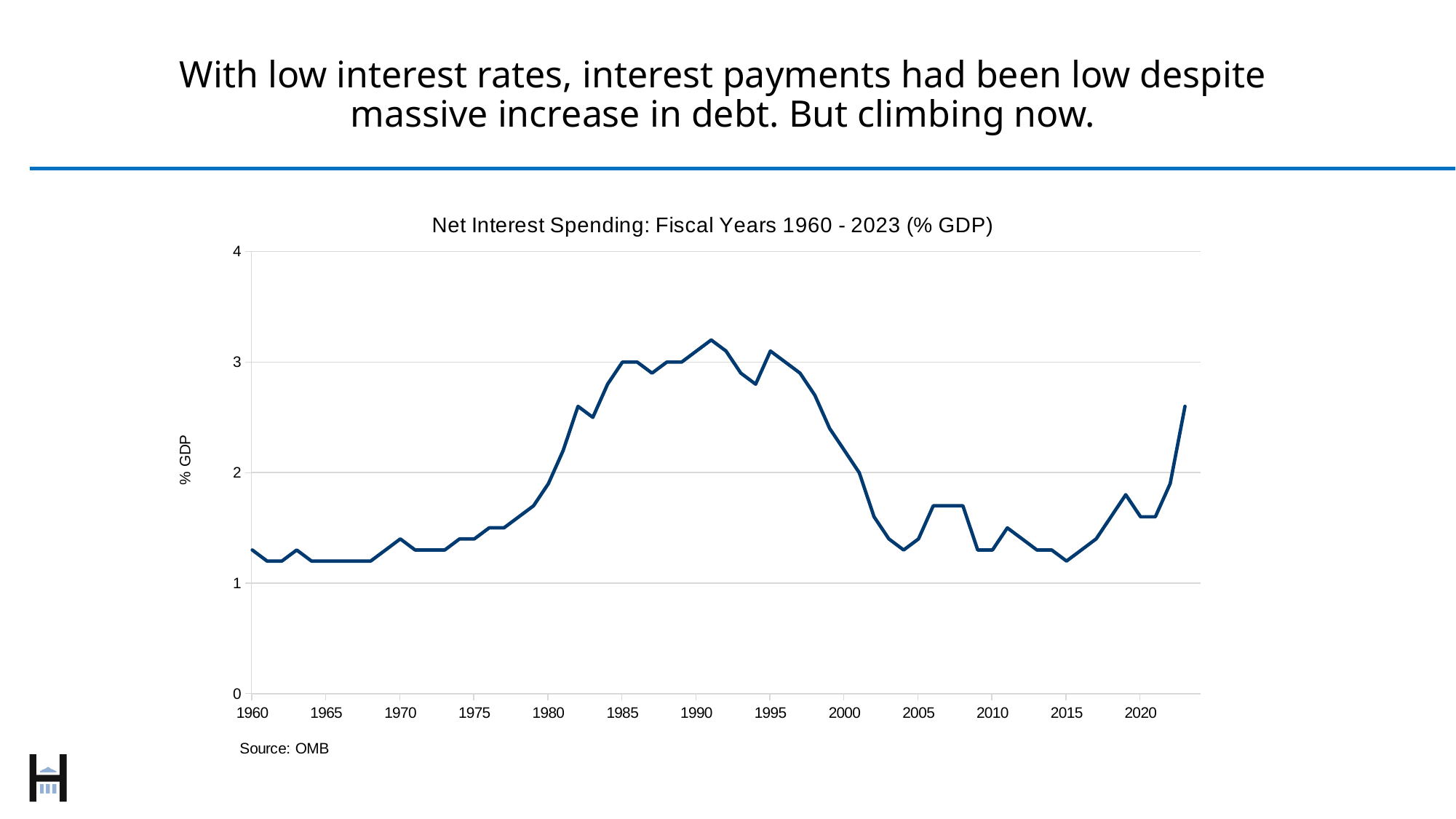
Is the value for 2010 greater or less than 2? less Do the values generally rise or fall between 1991 and 2015? fall What is the title of the chart? Net Interest Spending: Fiscal Years 1960 - 2023 (% GDP) Is the value for 1975 greater or less than 2? less Which year has the larger value, 1960 or 2023? 2023 Is the value for 2023 greater or less than 2? greater What is the label on the vertical axis of the chart? % GDP Which year has the larger value, 1991 or 2023? 1991 What kind of chart is shown on the slide? line chart